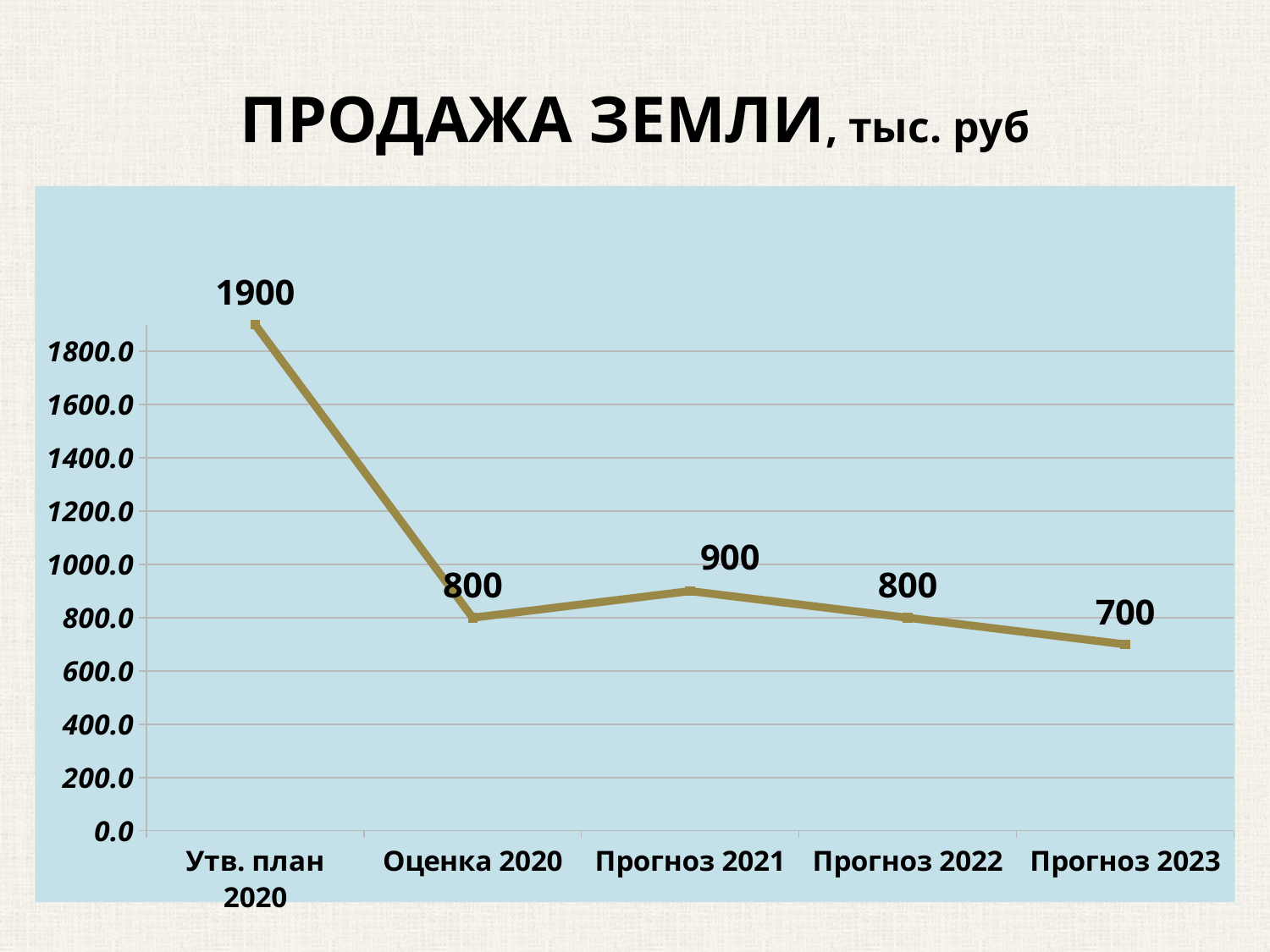
How many data points are plotted on the chart? 5 What is the difference between the values for Утв. план 2020 and Оценка 2020? 1100 What is the value for Прогноз 2021? 900 What kind of chart is shown on the slide? line chart Which category has the lowest value? Прогноз 2023 What is the value for Прогноз 2023? 700 What is the title of the chart? ПРОДАЖА ЗЕМЛИ, тыс. руб Which category has the highest value? Утв. план 2020 What is the value for Оценка 2020? 800 What is the value for Утв. план 2020? 1900 What is the difference between the values for Прогноз 2021 and Прогноз 2023? 200 Which is larger, the value for Прогноз 2021 or the value for Прогноз 2022? Прогноз 2021